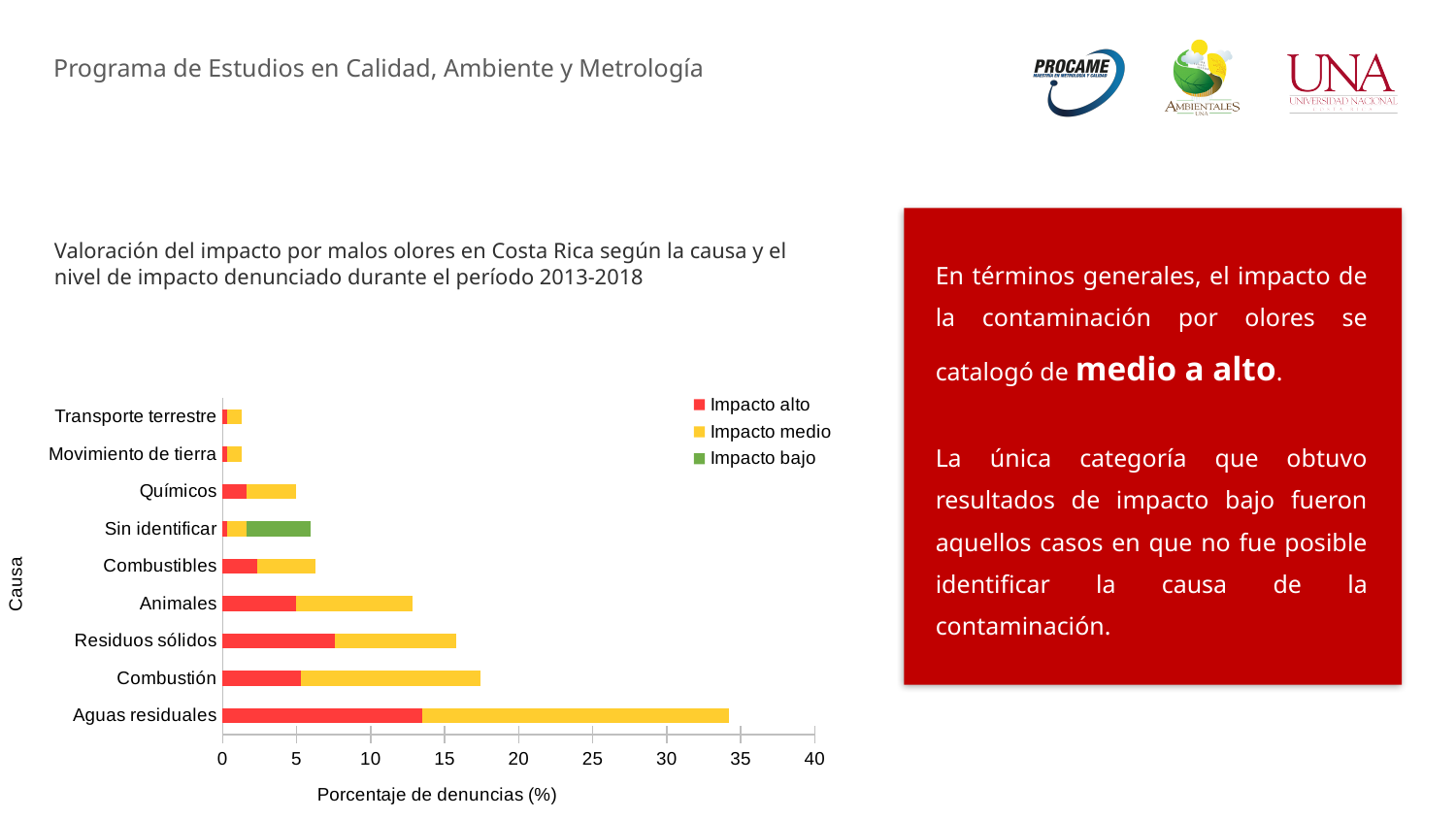
Is the total value for Químicos greater or less than 10? less Which cause has the longest total bar? Aguas residuales Which cause is the only one with an Impacto bajo segment? Sin identificar Is the total value for Combustión greater or less than 20? less Which has a longer total bar, Animales or Combustibles? Animales How many series does the chart legend list? 3 Is the total value for Animales greater or less than 10? greater How many causes (categories) are plotted on the chart? 9 What is the title of the horizontal axis? Porcentaje de denuncias (%) What kind of chart is shown on the slide? bar chart Which has a longer total bar, Aguas residuales or Combustión? Aguas residuales